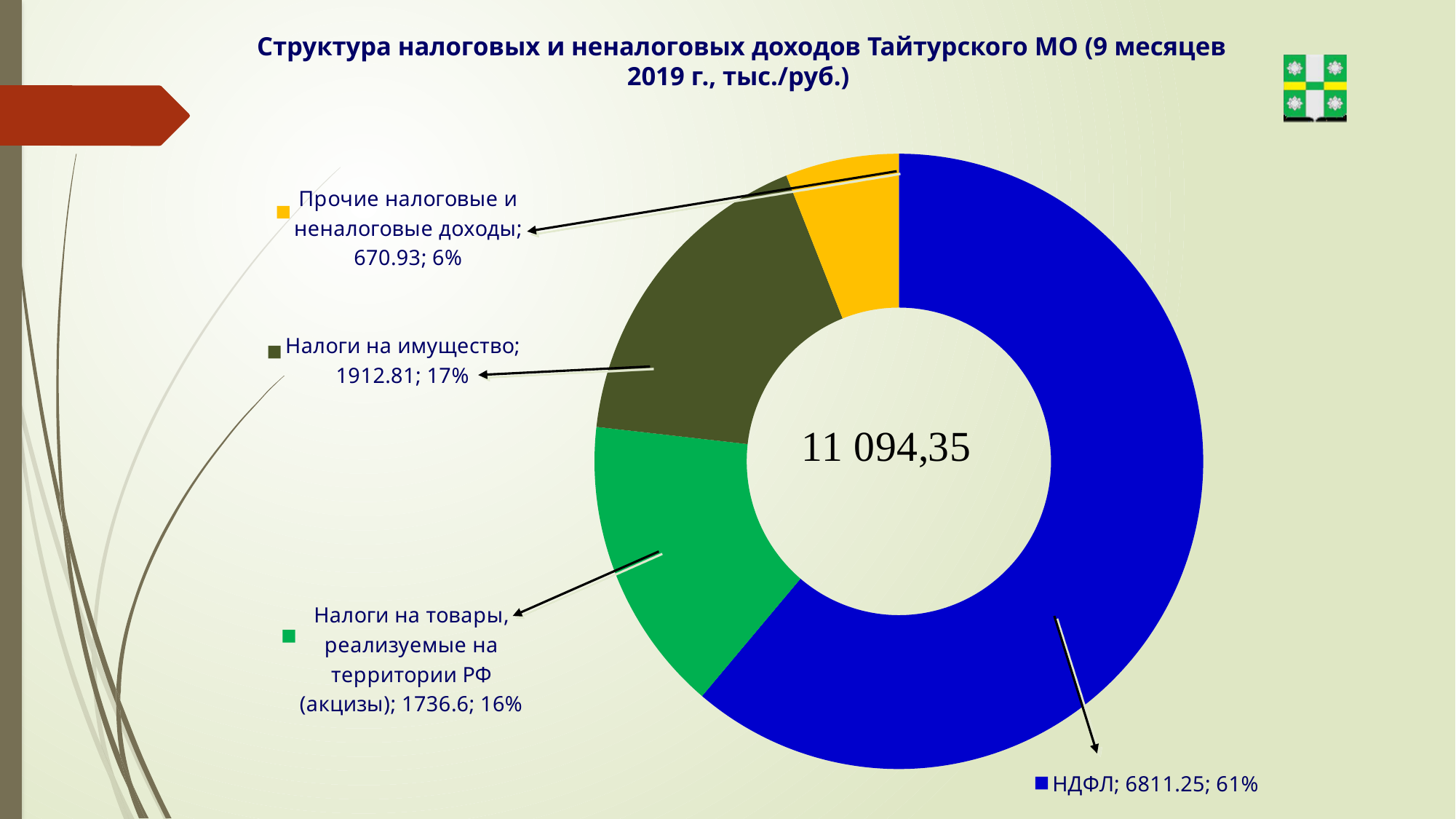
What is the difference between the values for Налоги на имущество and Налоги на товары (акцизы)? 176.21 What is the value for Налоги на имущество? 1912.81 What is the value for Налоги на товары, реализуемые на территории РФ (акцизы)? 1736.6 What share of the chart does НДФЛ represent? 61% How many categories are shown in the chart? 4 What share of the chart does Налоги на имущество represent? 17% What total value is shown in the centre of the doughnut chart? 11 094,35 Which category has the smallest slice? Прочие налоговые и неналоговые доходы Which category has the largest slice? НДФЛ What kind of chart is shown on the slide? Doughnut (pie) chart What is the value for Прочие налоговые и неналоговые доходы? 670.93 What is the value for НДФЛ? 6811.25